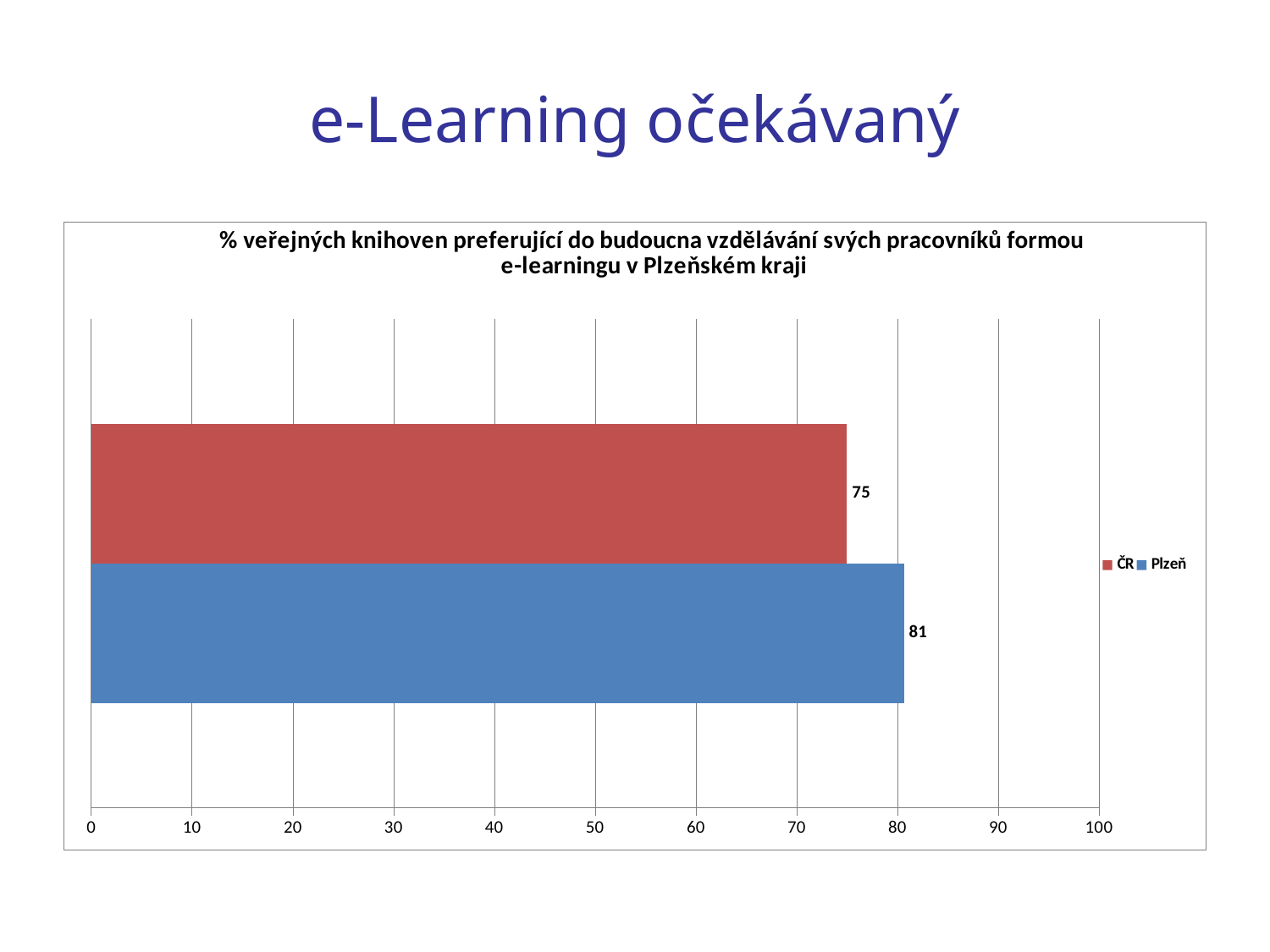
Which series has the higher value, ČR or Plzeň? Plzeň What is the maximum value shown on the horizontal axis? 100 Which series has the highest value? Plzeň How many series does the legend list? 2 Which series has the lowest value? ČR What kind of chart is shown on the slide? bar chart What colour is the bar for Plzeň? blue Is the value for Plzeň greater or less than 80? greater Is the value for ČR greater or less than 80? less What is the value for ČR? 75 What is the difference between the values for Plzeň and ČR? 6 What is the value for Plzeň? 81